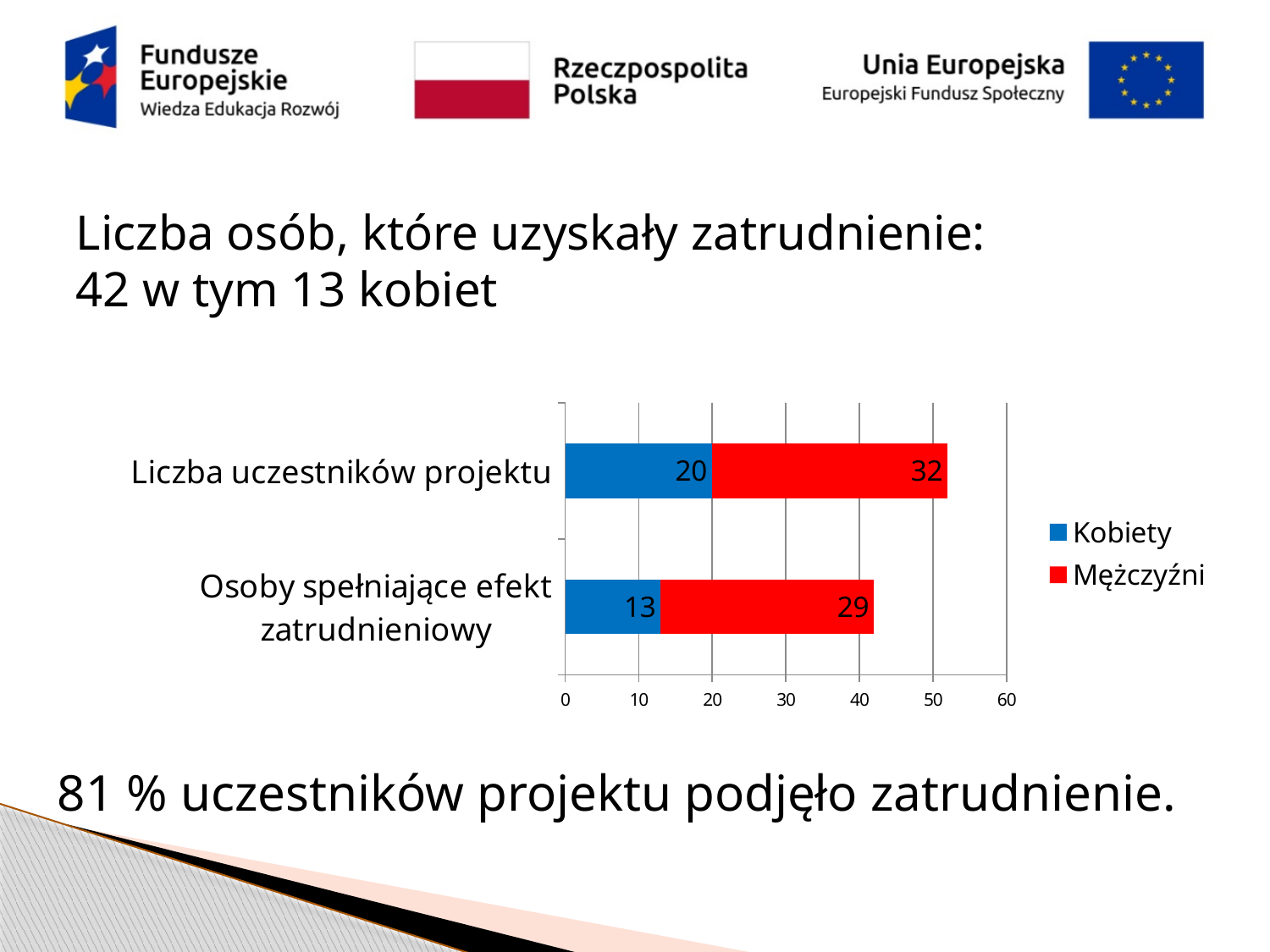
What is the total of the Liczba uczestników projektu stacked bar? 52 What is the total of the Osoby spełniające efekt zatrudnieniowy stacked bar? 42 What kind of chart is shown on the slide? Stacked bar chart Which series has the larger value in the Osoby spełniające efekt zatrudnieniowy bar, Kobiety or Mężczyźni? Mężczyźni What is the value for Kobiety in the Osoby spełniające efekt zatrudnieniowy bar? 13 What is the value for Mężczyźni in the Osoby spełniające efekt zatrudnieniowy bar? 29 What is the value for Kobiety in the Liczba uczestników projektu bar? 20 What is the value for Mężczyźni in the Liczba uczestników projektu bar? 32 What is the difference between the Kobiety values for Liczba uczestników projektu and Osoby spełniające efekt zatrudnieniowy? 7 What is the difference between the Mężczyźni and Kobiety values for Liczba uczestników projektu? 12 How many categories are shown on the chart? 2 How many series does the legend list? 2